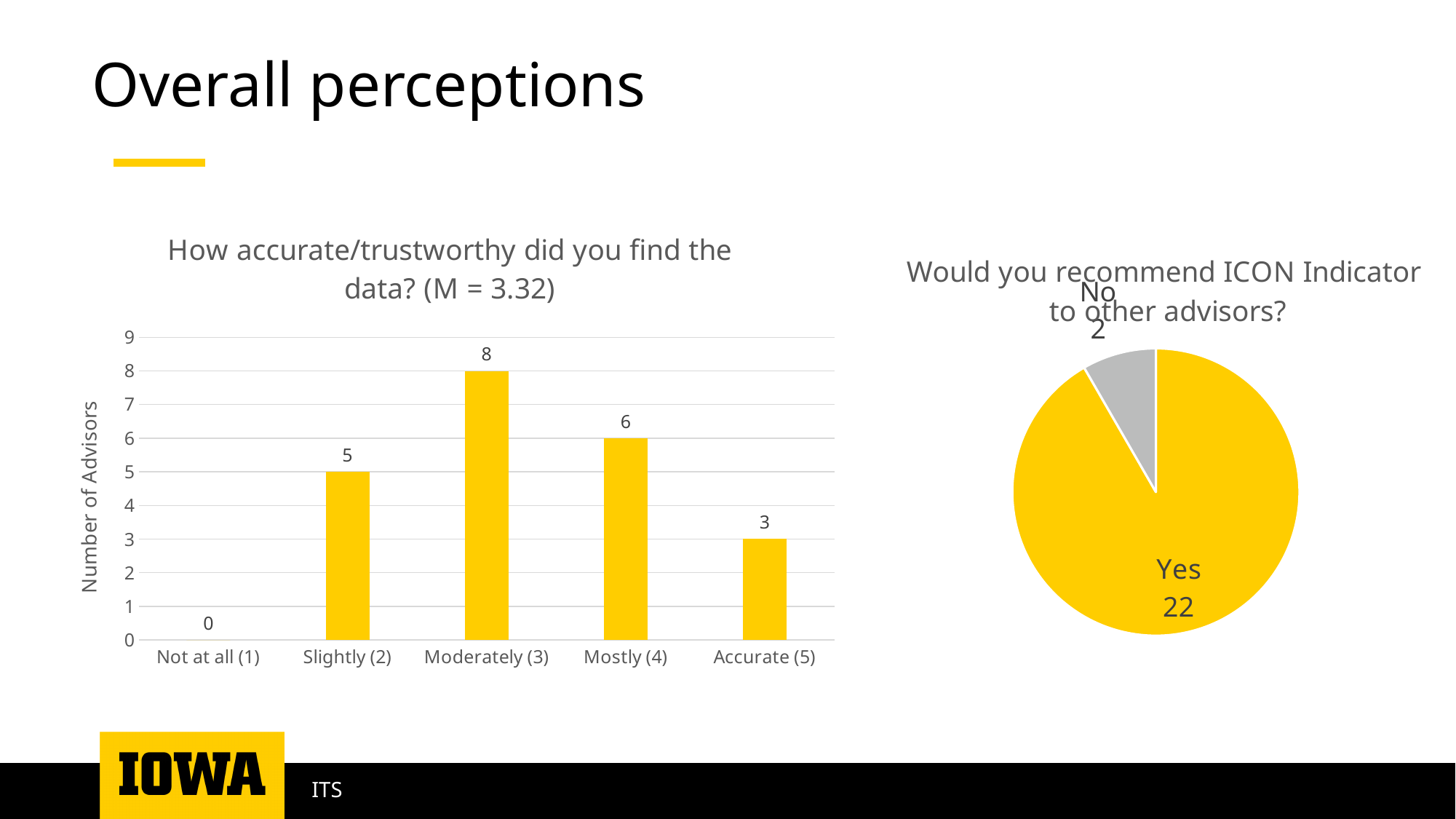
In the bar chart 'How accurate/trustworthy did you find the data?', which category has the lowest number of advisors? Not at all (1) What kind of chart is the chart on the right of the slide? Pie chart In the pie chart 'Would you recommend ICON Indicator to other advisors?', how many advisors answered Yes? 22 In the bar chart 'How accurate/trustworthy did you find the data?', how many advisors answered Accurate (5)? 3 In the bar chart 'How accurate/trustworthy did you find the data?', how many advisors answered Moderately (3)? 8 In the bar chart 'How accurate/trustworthy did you find the data?', which has more advisors: Slightly (2) or Mostly (4)? Mostly (4) In the bar chart 'How accurate/trustworthy did you find the data?', what is the difference between the number of advisors for Moderately (3) and Mostly (4)? 2 How many categories are shown on the x axis of the bar chart 'How accurate/trustworthy did you find the data?'? 5 What is the y-axis label of the bar chart 'How accurate/trustworthy did you find the data?'? Number of Advisors In the pie chart 'Would you recommend ICON Indicator to other advisors?', how many advisors answered No? 2 In the bar chart 'How accurate/trustworthy did you find the data?', which category has the highest number of advisors? Moderately (3) What kind of chart is the chart on the left of the slide? Bar chart